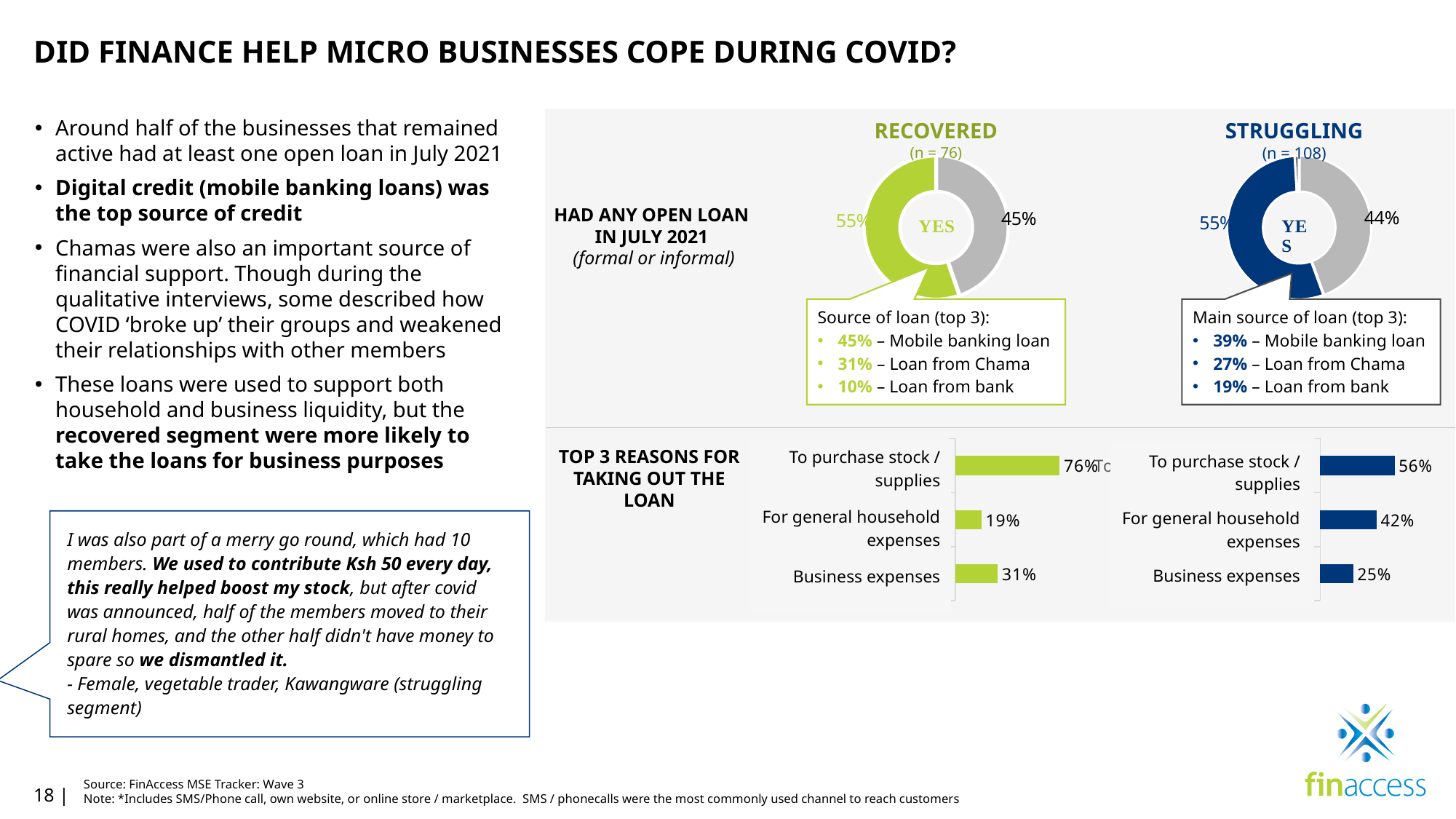
In the Struggling donut chart for 'Had any open loan in July 2021', what is the value of the grey (non-YES) segment? 44% Comparing the two bar charts for top 3 reasons for taking out the loan, which segment has the larger value for 'Business expenses', Recovered or Struggling? Recovered How many reasons are shown in the Recovered bar chart for top 3 reasons for taking out the loan? 3 What type of chart is used to show the top 3 reasons for taking out the loan? Bar chart In the Recovered bar chart for top 3 reasons for taking out the loan, what is the difference between 'To purchase stock / supplies' and 'Business expenses'? 45 percentage points In the Struggling bar chart for top 3 reasons for taking out the loan, which reason has the highest value? To purchase stock / supplies In the Recovered bar chart for top 3 reasons for taking out the loan, what is the value for 'To purchase stock / supplies'? 76% In the Struggling bar chart for top 3 reasons for taking out the loan, what is the value for 'For general household expenses'? 42% In the Recovered bar chart for top 3 reasons for taking out the loan, which reason has the lowest value? For general household expenses What colour are the bars in the Struggling bar chart for top 3 reasons for taking out the loan? Dark blue In the Struggling bar chart for top 3 reasons for taking out the loan, what is the difference between 'To purchase stock / supplies' and 'For general household expenses'? 14 percentage points In the Recovered donut chart for 'Had any open loan in July 2021', what share answered YES? 55%